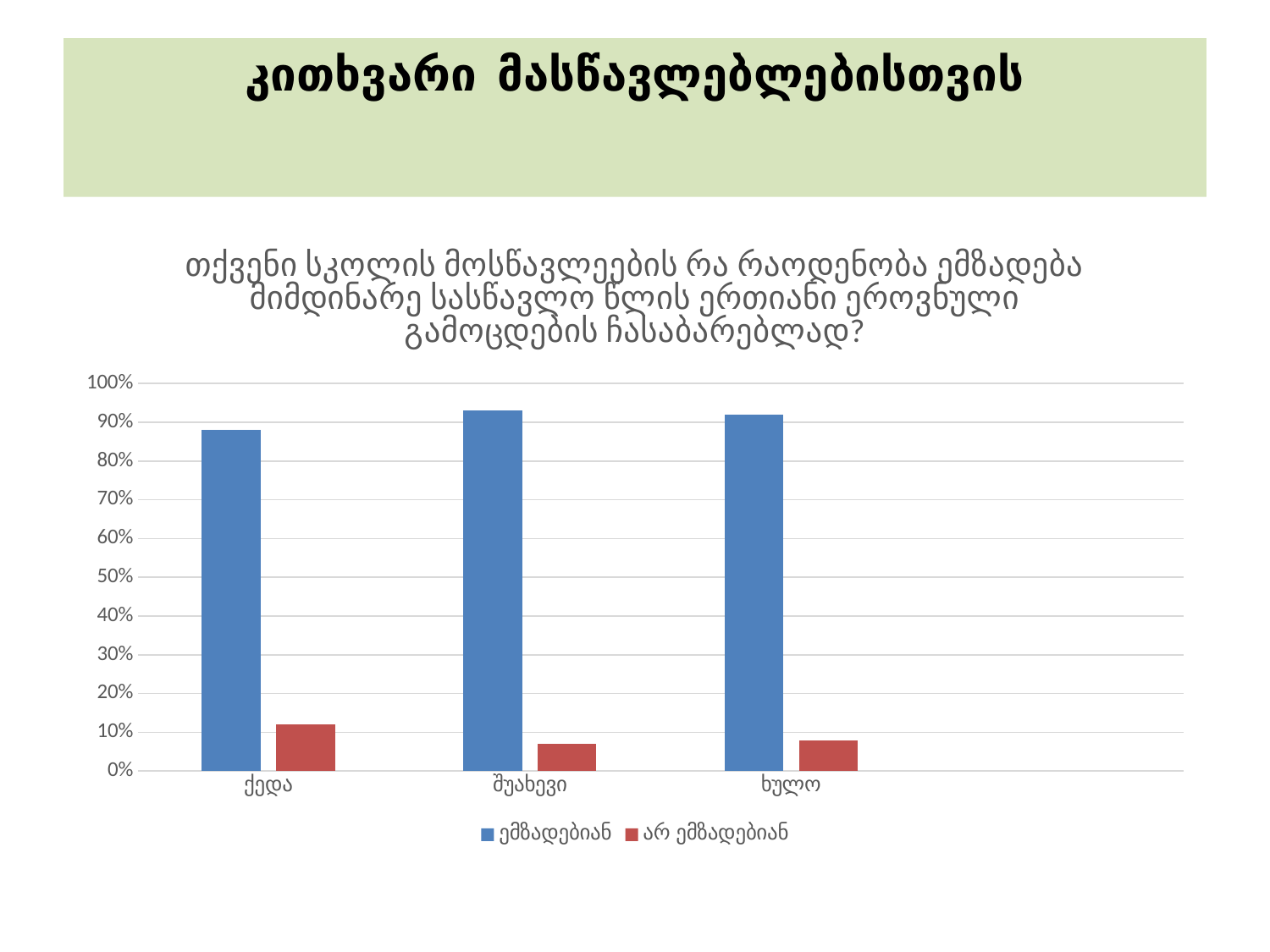
Is the value for არ ემზადებიან in ხულო greater or less than 10%? less How many categories are shown on the x axis of the chart? 3 Is the value for არ ემზადებიან in ქედა greater or less than 10%? greater How many series does the chart legend list? 2 Which category has the lowest value for the ემზადებიან series? ქედა Is the value for ემზადებიან in ქედა greater or less than 80%? greater Which colour represents the არ ემზადებიან series in the chart? red What kind of chart is shown on the slide? bar chart In ქედა, which series has the larger value, ემზადებიან or არ ემზადებიან? ემზადებიან Which category has the highest value for the არ ემზადებიან series? ქედა